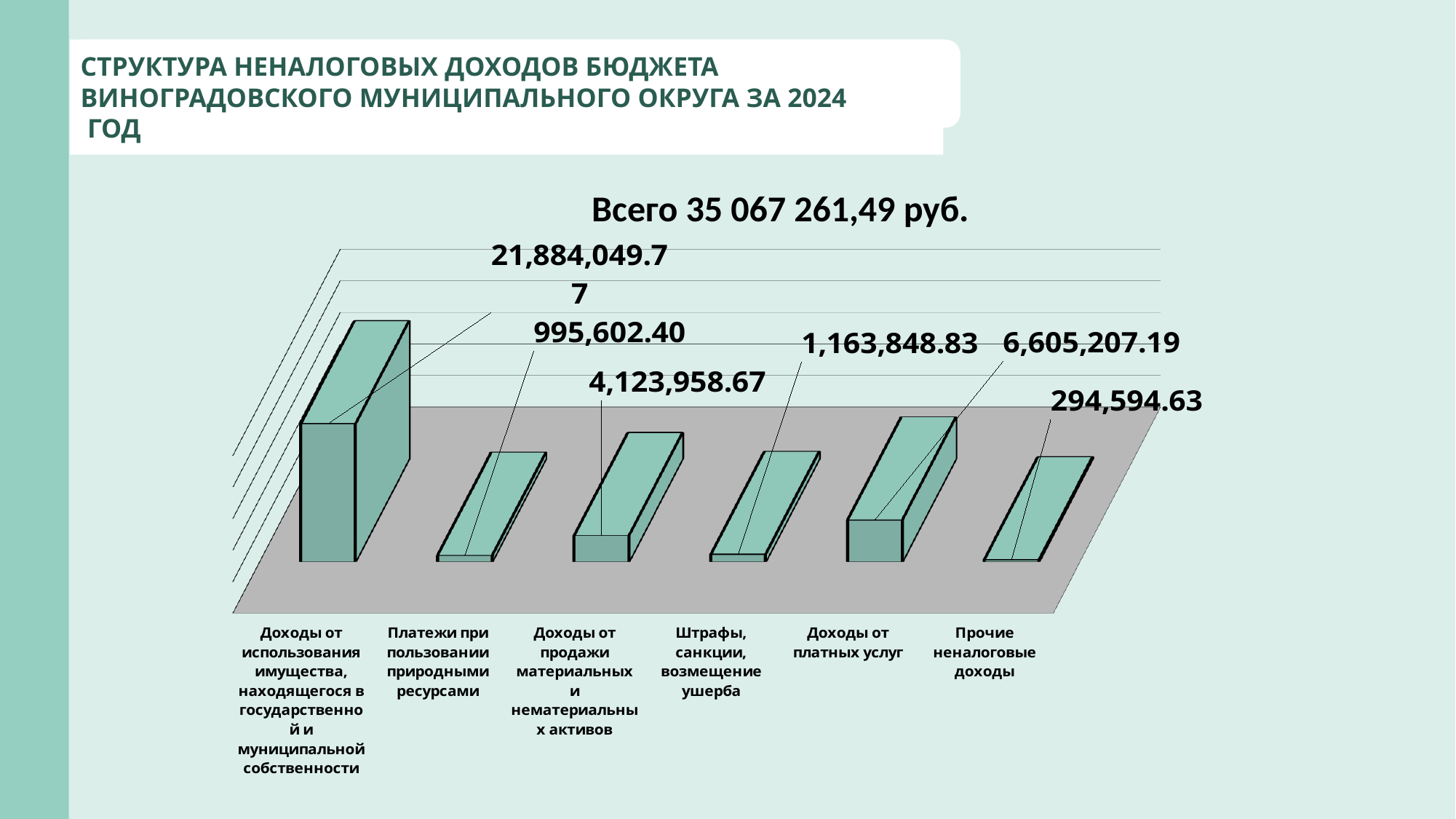
What is the value for Прочие неналоговые доходы? 294,594.63 What total amount is stated in the chart title? 35 067 261,49 руб. What kind of chart is shown on the slide? Bar chart What is the difference between the values for Платежи при пользовании природными ресурсами and Прочие неналоговые доходы? 701,007.77 Which category has the highest value? Доходы от использования имущества, находящегося в государственной и муниципальной собственности What is the difference between the values for Доходы от платных услуг and Доходы от продажи материальных и нематериальных активов? 2,481,248.52 What is the value for Штрафы, санкции, возмещение ущерба? 1,163,848.83 How many categories are shown in the chart? 6 Which is larger: the value for Штрафы, санкции, возмещение ущерба or the value for Платежи при пользовании природными ресурсами? Штрафы, санкции, возмещение ущерба What is the value for Платежи при пользовании природными ресурсами? 995,602.40 What is the value for Доходы от платных услуг? 6,605,207.19 Which category has the lowest value? Прочие неналоговые доходы